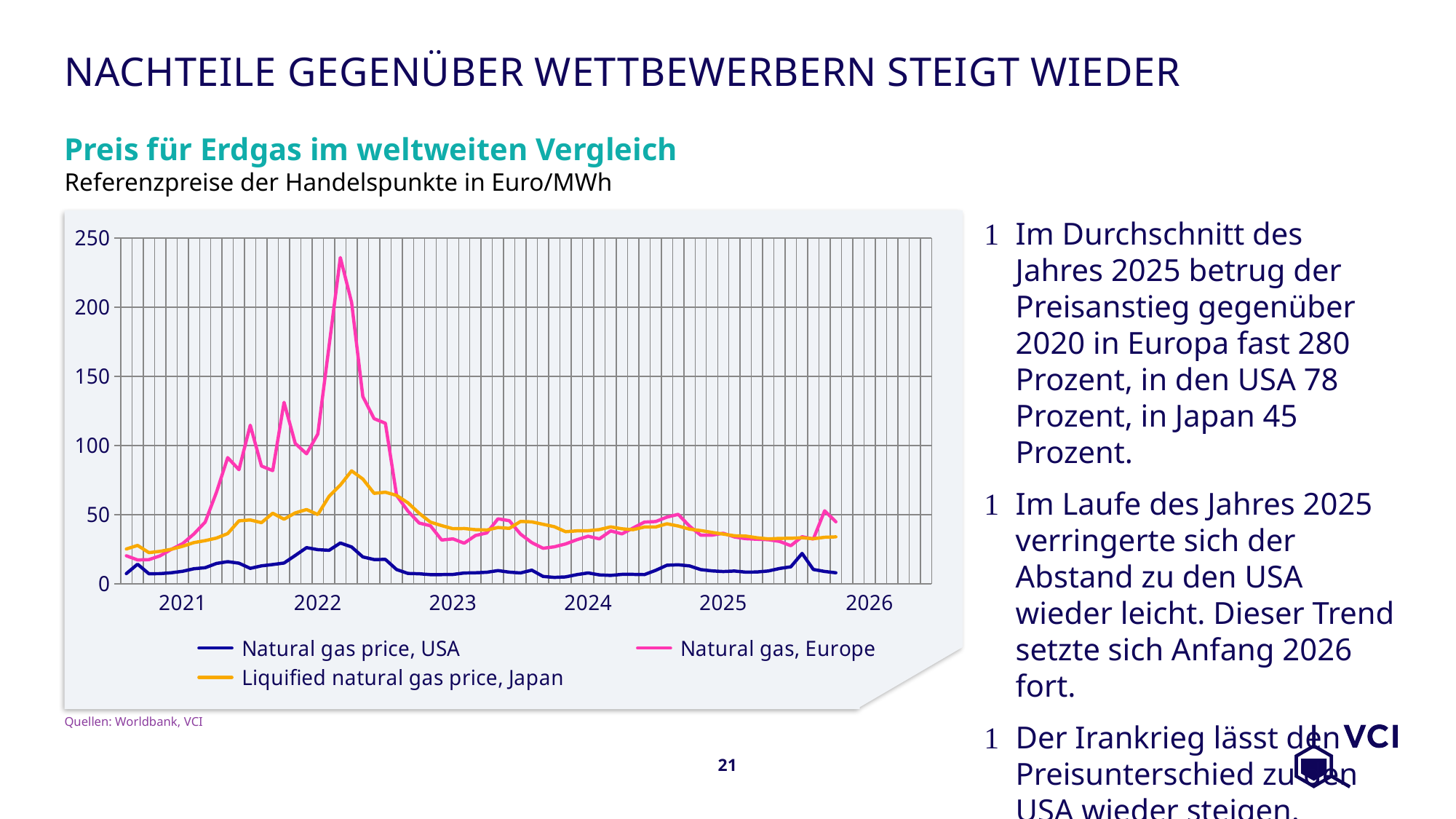
How many series does the legend of the chart list? 3 Which series stays lowest across the whole period shown in the chart? Natural gas price, USA In 2022, which is larger: the peak of Natural gas, Europe or the peak of Liquified natural gas price, Japan? Natural gas, Europe Is the Natural gas price, USA series ever greater or less than 50 over the period shown? less What kind of chart is shown on the slide? line chart Does the Natural gas, Europe series rise or fall from its 2022 peak to 2023? fall Is the peak value of the Liquified natural gas price, Japan series greater or less than 100? less Which series is drawn in pink in the chart? Natural gas, Europe Is the peak value of the Liquified natural gas price, Japan series greater or less than 50? greater What is the title of the chart? Preis für Erdgas im weltweiten Vergleich Which series reaches the highest value in the chart? Natural gas, Europe